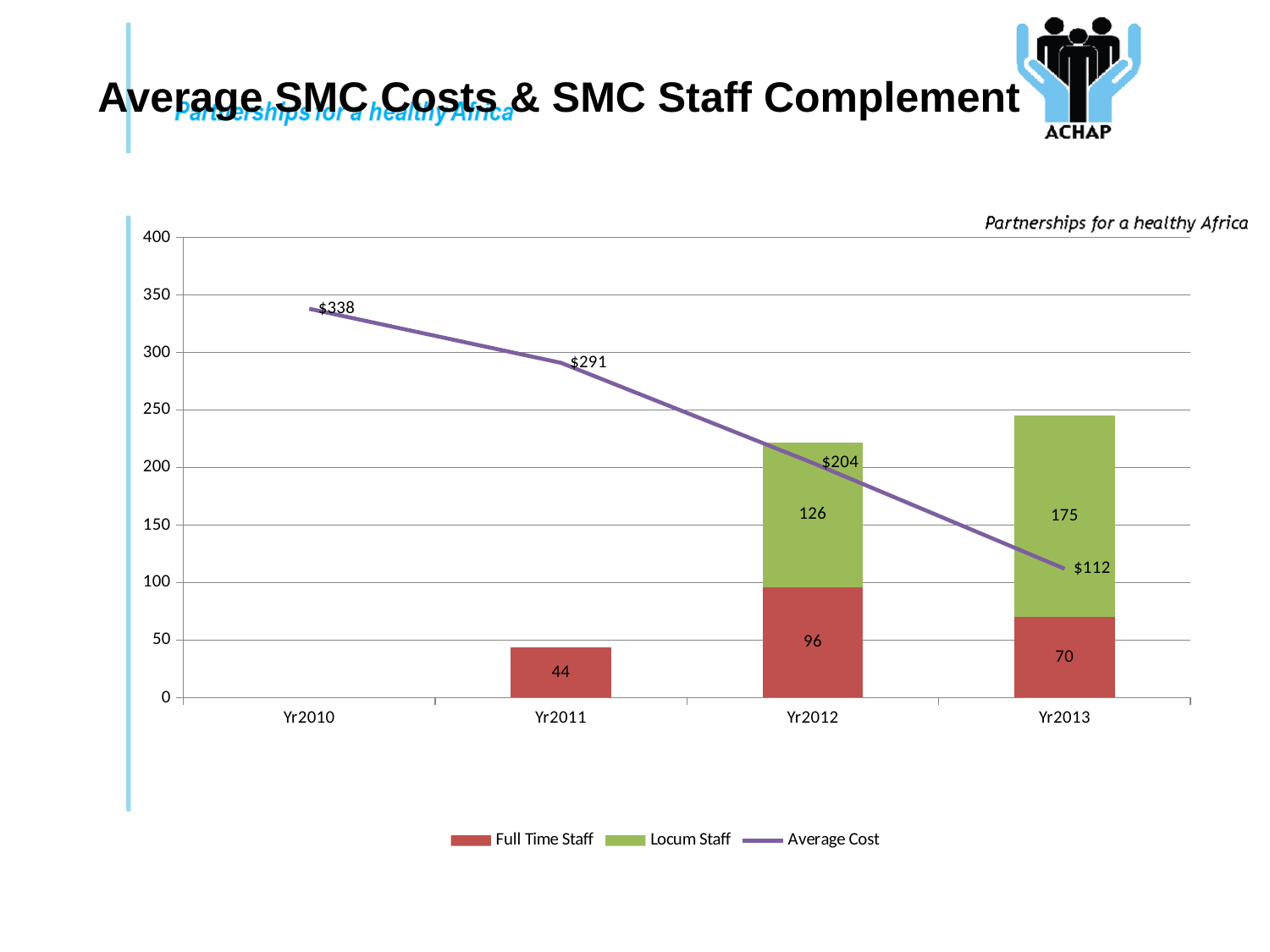
What colour represents Locum Staff in the chart? green What is the Locum Staff value for Yr2013? 175 What is the difference between the Average Cost in Yr2011 and Yr2012? $87 What is the Average Cost for Yr2013? $112 Which year has the lowest Average Cost? Yr2013 What is the total of the stacked bar for Yr2012 (Full Time Staff plus Locum Staff)? 222 How many series does the legend list? 3 Which is larger, the Full Time Staff value for Yr2012 or for Yr2013? Yr2012 What is the Full Time Staff value for Yr2012? 96 What is the Average Cost for Yr2010? $338 Does the Average Cost rise or fall from Yr2010 to Yr2013? fall Which year has the highest Average Cost? Yr2010